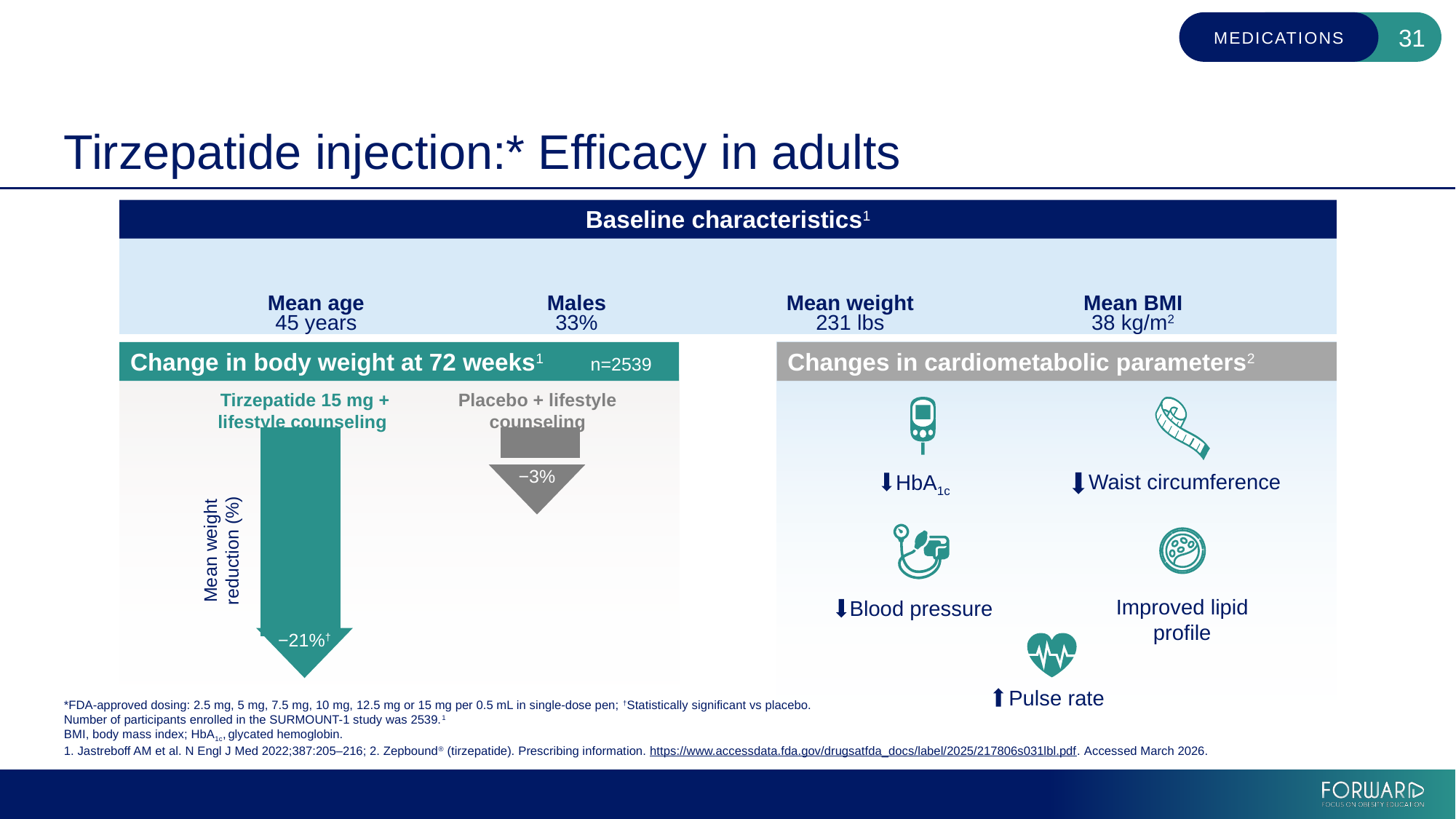
In the 'Change in body weight at 72 weeks' chart, which group shows the smallest mean weight reduction? Placebo + lifestyle counseling How many treatment groups are shown in the 'Change in body weight at 72 weeks' chart? 2 In the 'Change in body weight at 72 weeks' chart, which group had a greater mean weight reduction, tirzepatide or placebo? Tirzepatide 15 mg + lifestyle counseling In the 'Change in body weight at 72 weeks' chart, which group shows the largest mean weight reduction? Tirzepatide 15 mg + lifestyle counseling What sample size (n) is shown in the header of the 'Change in body weight at 72 weeks' chart? n=2539 In the 'Change in body weight at 72 weeks' chart, what is the mean weight reduction for Tirzepatide 15 mg + lifestyle counseling? −21% In the 'Change in body weight at 72 weeks' chart, what is the mean weight reduction for Placebo + lifestyle counseling? −3% What is the label on the vertical axis of the 'Change in body weight at 72 weeks' chart? Mean weight reduction (%) In the 'Change in body weight at 72 weeks' chart, what is the difference in mean weight reduction between the tirzepatide group and the placebo group? 18 percentage points